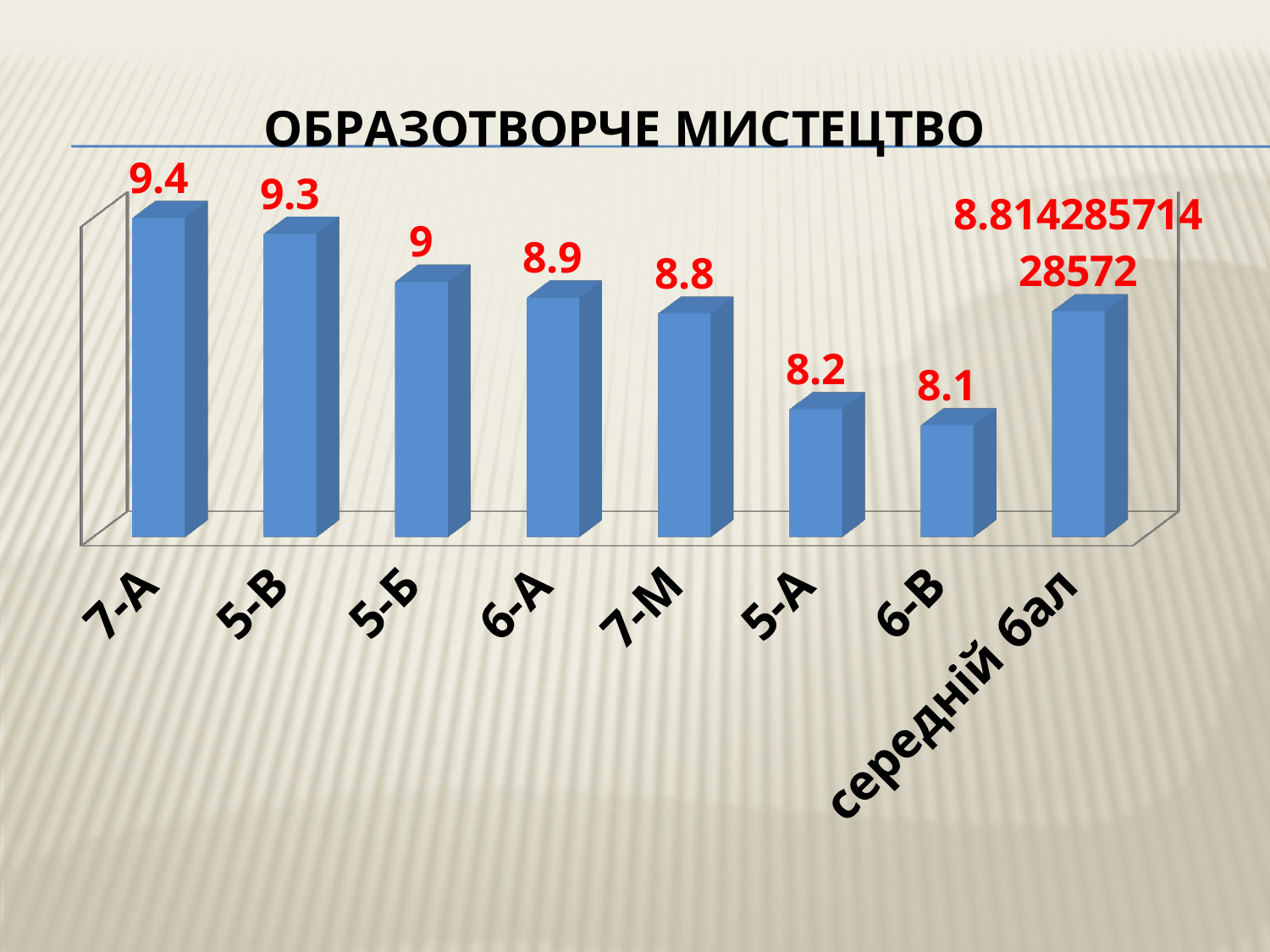
What kind of chart is shown on the slide? Bar chart What is the title of the chart? ОБРАЗОТВОРЧЕ МИСТЕЦТВО What is the difference between the values for 5-В and 5-А? 1.1 What is the value shown for середній бал? 8.81428571428572 What is the value for 6-В? 8.1 Which class has the lowest value? 6-В Which is larger, the value for 6-А or the value for 7-М? 6-А How many bars are plotted in the chart? 8 What is the value for 7-А? 9.4 What is the value for 5-Б? 9 What is the difference between the values for 7-А and 6-В? 1.3 Which class has the highest value? 7-А